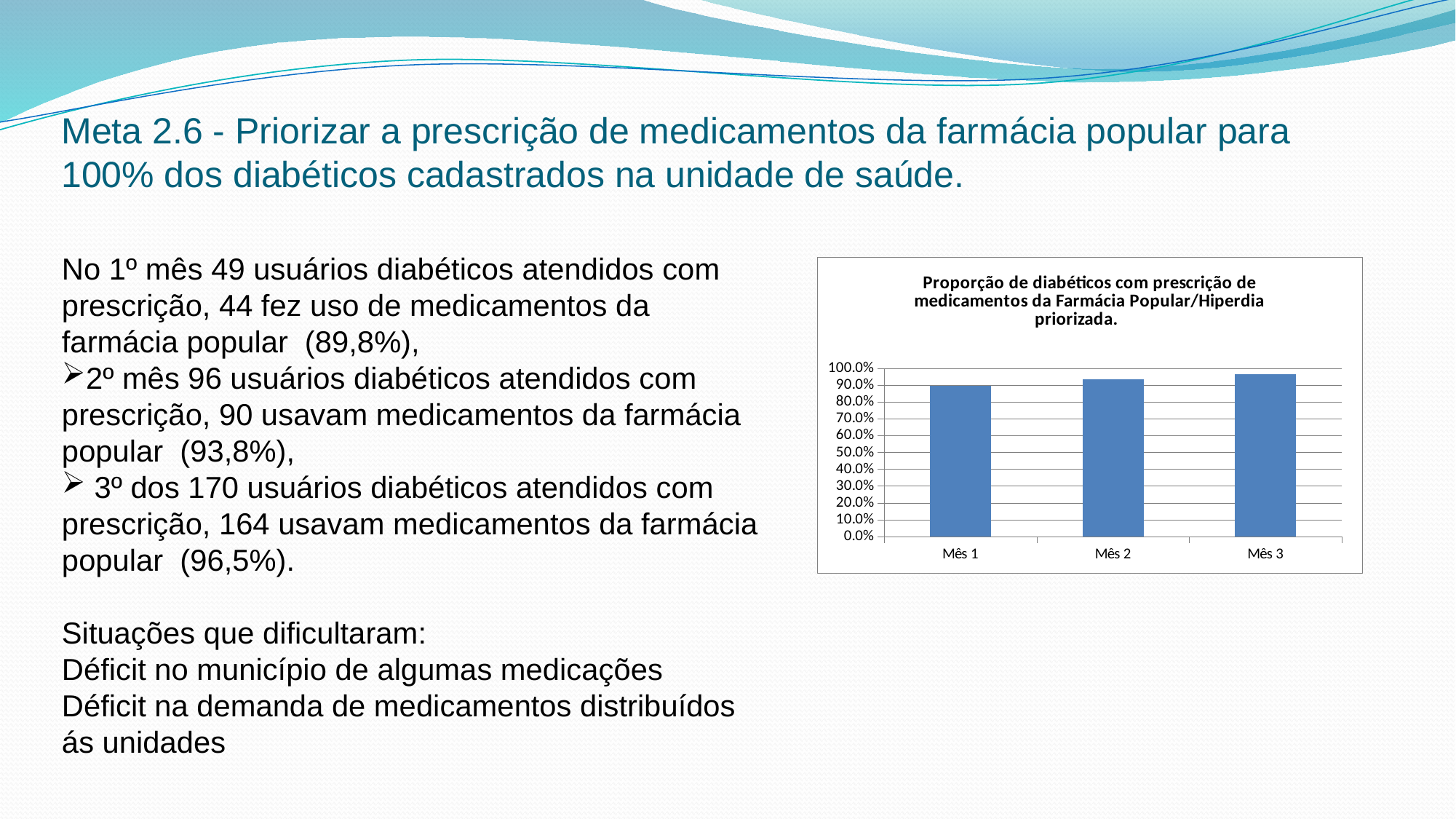
What kind of chart is shown on the slide? bar chart Do the values rise or fall from Mês 1 to Mês 3? rise What is the title of the chart? Proporção de diabéticos com prescrição de medicamentos da Farmácia Popular/Hiperdia priorizada. Is the value for Mês 3 greater or less than 100.0%? less How many categories (months) are plotted on the chart? 3 What is the highest value shown on the vertical axis of the chart? 100.0% Is the value for Mês 2 greater or less than 90.0%? greater Which is larger, the value for Mês 1 or the value for Mês 3? Mês 3 Which month has the highest bar on the chart? Mês 3 Is the value for Mês 1 greater or less than 80.0%? greater Which month has the lowest bar on the chart? Mês 1